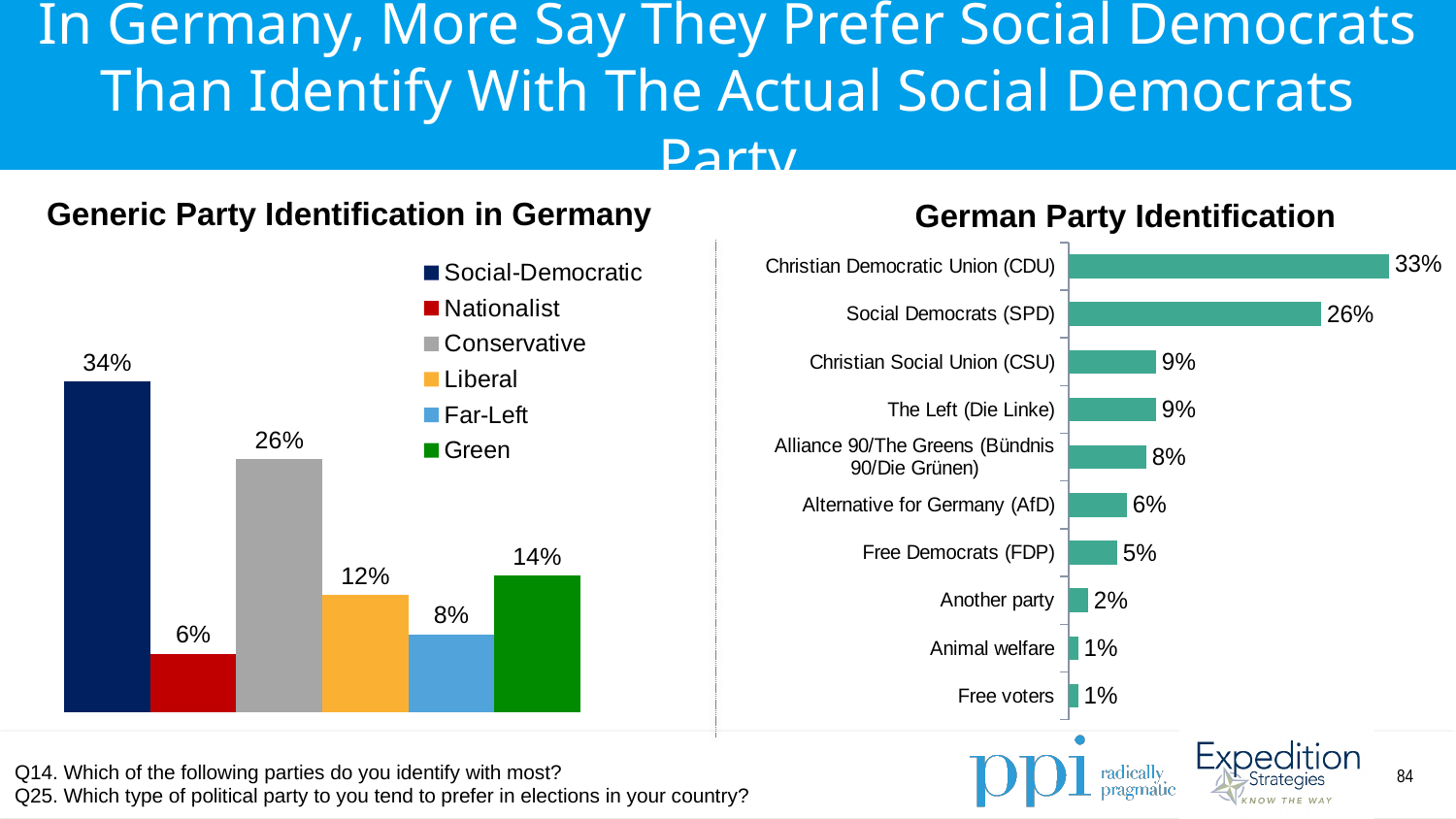
In the 'German Party Identification' chart, which party has the highest value? Christian Democratic Union (CDU) What kind of chart is the 'German Party Identification' chart? Bar chart In the 'Generic Party Identification in Germany' chart, which category has the lowest value? Nationalist In the 'German Party Identification' chart, what is the difference between Christian Democratic Union (CDU) and Social Democrats (SPD)? 7% In the 'Generic Party Identification in Germany' chart, what is the difference between Conservative and Liberal? 14% In the 'German Party Identification' chart, what is the value for Alternative for Germany (AfD)? 6% How many categories are shown in the 'German Party Identification' chart? 10 In the 'Generic Party Identification in Germany' chart, what is the value for Social-Democratic? 34% In the 'Generic Party Identification in Germany' chart, what colour is the Liberal bar? Orange How many series does the legend of the 'Generic Party Identification in Germany' chart list? 6 In the 'Generic Party Identification in Germany' chart, which is larger, Green or Far-Left? Green In the 'German Party Identification' chart, what is the value for Social Democrats (SPD)? 26%